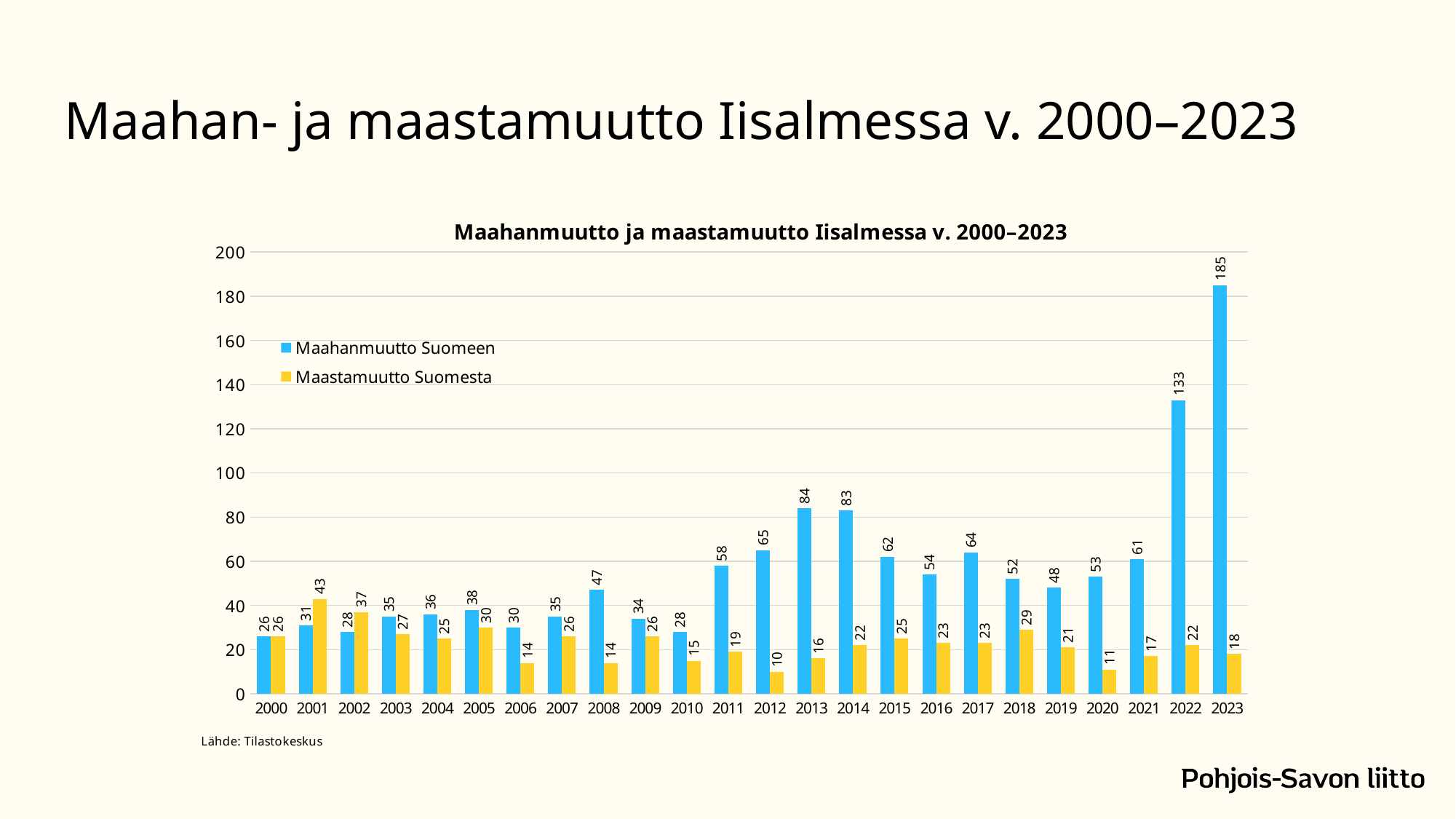
How many years are shown on the x axis? 24 How many series does the legend list? 2 What is the difference between Maahanmuutto Suomeen and Maastamuutto Suomesta in 2022? 111 Which year has the lowest value for Maastamuutto Suomesta? 2012 What is the value for Maahanmuutto Suomeen in 2023? 185 What is the value for Maastamuutto Suomesta in 2001? 43 Is the value for Maahanmuutto Suomeen in 2022 greater or less than 120? greater What is the value for Maahanmuutto Suomeen in 2013? 84 What kind of chart is shown on the slide? Bar chart Which year has the highest value for Maahanmuutto Suomeen? 2023 Which is larger in 2002: Maahanmuutto Suomeen or Maastamuutto Suomesta? Maastamuutto Suomesta What is the source cited below the chart? Tilastokeskus